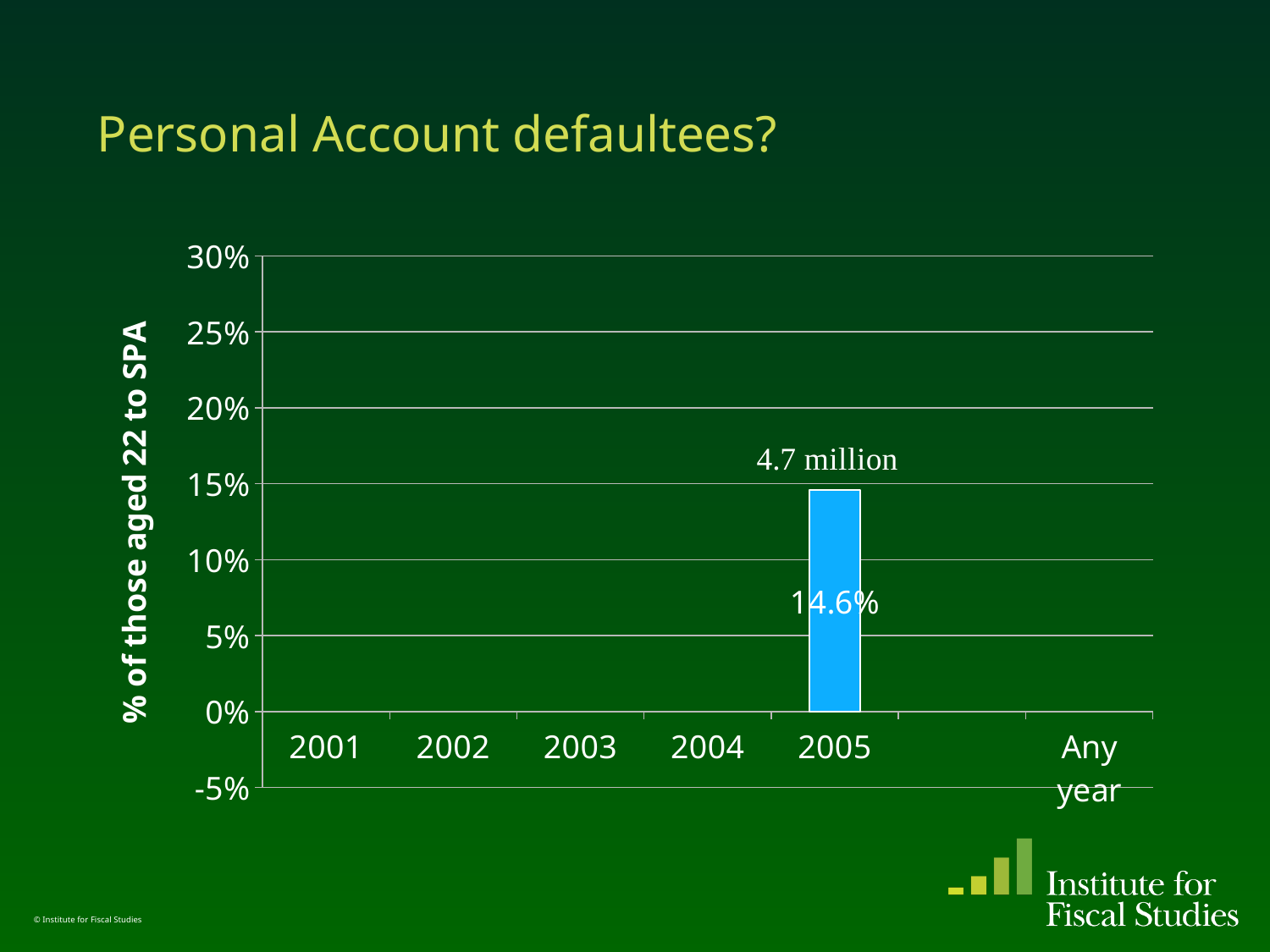
What text is printed above the 2005 bar? 4.7 million What kind of chart is shown on the slide? bar chart How many category labels are shown along the x axis? 6 Which year is the only one with a bar plotted? 2005 What is the title of the chart? Personal Account defaultees? Is the value for 2005 greater or less than 10%? greater What is the value shown for 2005? 14.6% Is the value for 2005 greater or less than 15%? less How many bars are plotted on the chart? 1 Which category has the highest value on the chart? 2005 Is the value for 2005 greater or less than 20%? less